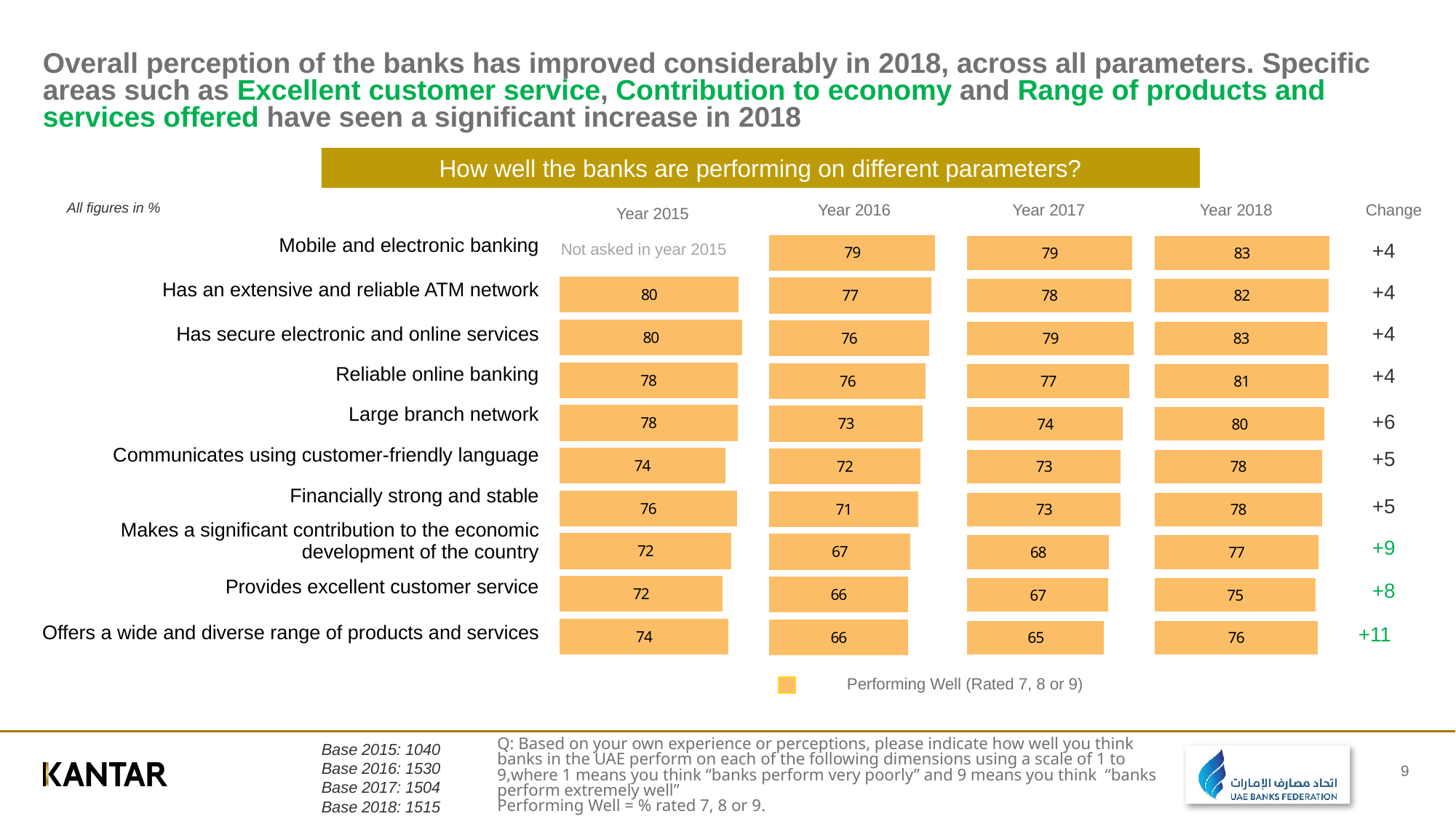
In the Year 2018 chart, which parameter has the lowest value? Provides excellent customer service In the Year 2016 chart, which parameter has the highest value? Mobile and electronic banking In the Year 2017 chart, which parameter has the lowest value? Offers a wide and diverse range of products and services Which is larger: the Year 2015 value for Has an extensive and reliable ATM network or the Year 2016 value for the same parameter? Year 2015 In the Year 2015 chart, what is the value for Large branch network? 78 How many parameters have a bar in the Year 2015 chart? 9 In the Year 2018 chart, what is the value for Provides excellent customer service? 75 What does the legend say the bars represent? Performing Well (Rated 7, 8 or 9) What is the difference between the Year 2018 and Year 2017 values for Offers a wide and diverse range of products and services? 11 In the Year 2016 chart, what is the value for Makes a significant contribution to the economic development of the country? 67 What is the Change value shown for Large branch network? +6 What type of chart is used to show the Year 2018 values? Bar chart